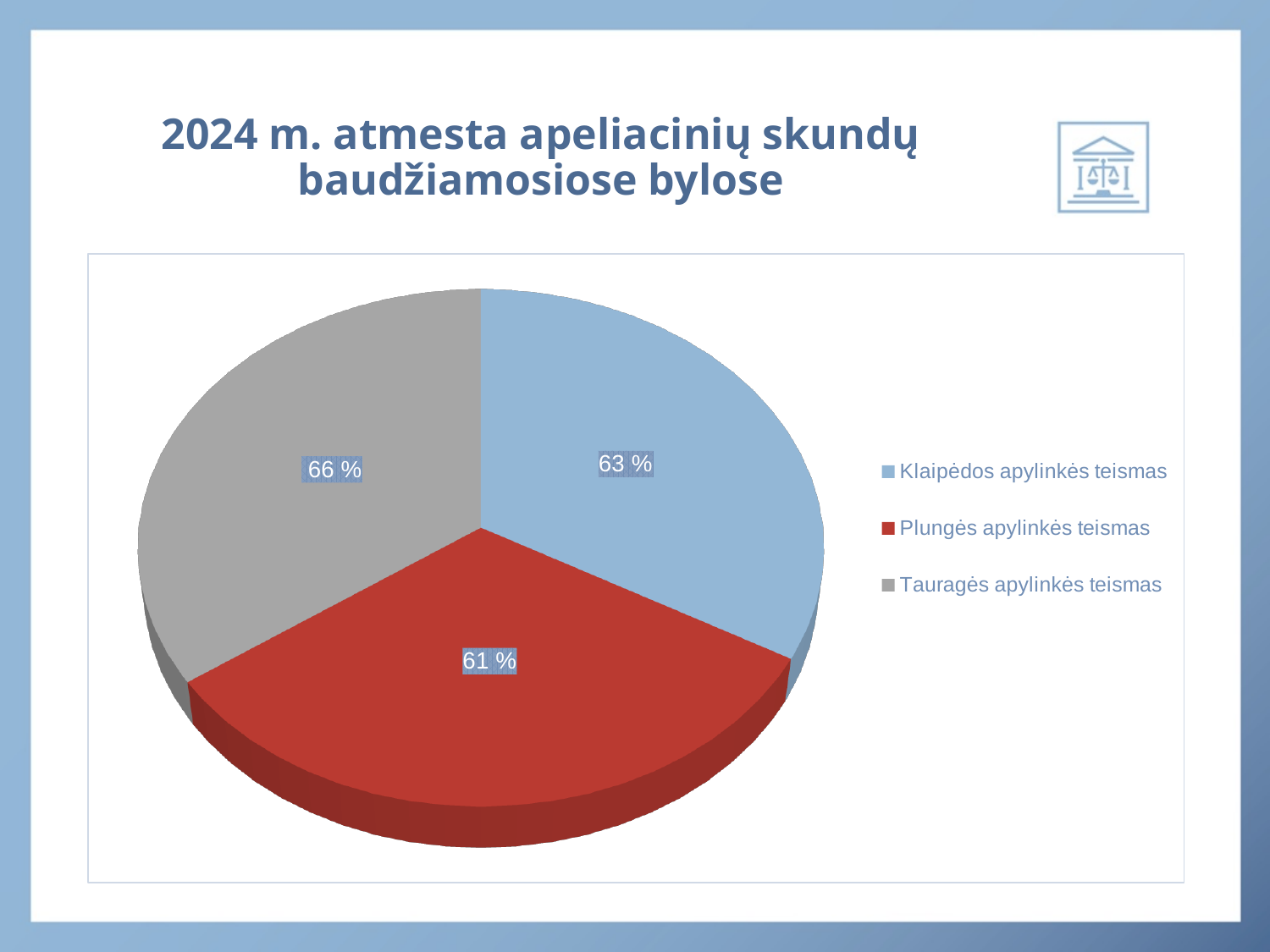
What is the value shown for Klaipėdos apylinkės teismas? 63 % What is the value shown for Plungės apylinkės teismas? 61 % What is the value shown for Tauragės apylinkės teismas? 66 % What kind of chart is shown on the slide? pie chart Which colour represents Plungės apylinkės teismas in the chart? red Which has the larger value, Klaipėdos apylinkės teismas or Tauragės apylinkės teismas? Tauragės apylinkės teismas What is the title of the slide? 2024 m. atmesta apeliacinių skundų baudžiamosiose bylose How many slices does the pie chart have? 3 Which court has the highest value in the chart? Tauragės apylinkės teismas Which court has the lowest value in the chart? Plungės apylinkės teismas What is the difference between the values for Tauragės apylinkės teismas and Plungės apylinkės teismas? 5 % What is the difference between the values for Klaipėdos apylinkės teismas and Plungės apylinkės teismas? 2 %